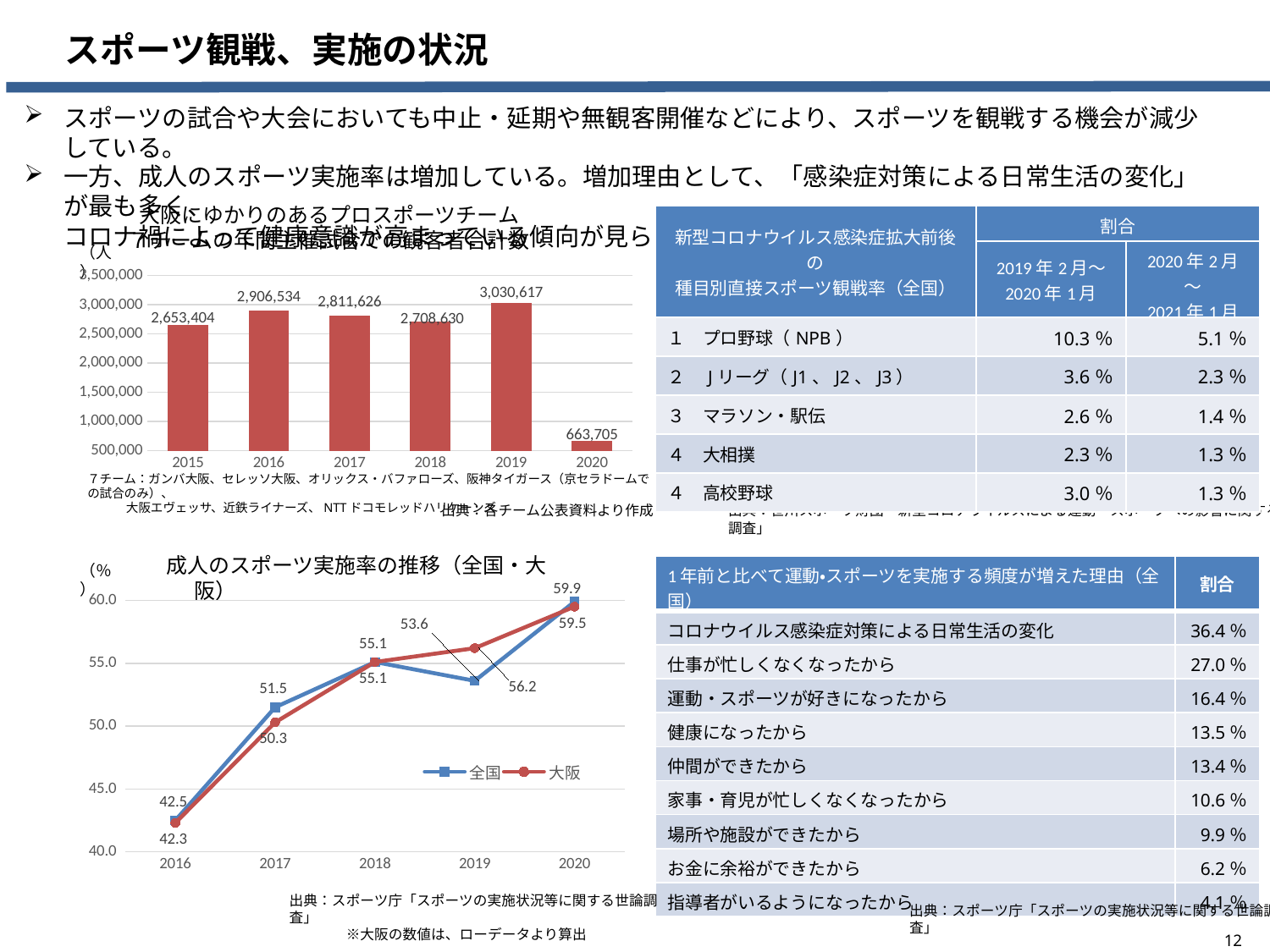
In the chart titled 成人のスポーツ実施率の推移（全国・大阪）, what is the value for 全国 in 2020? 59.9 In the top-left bar chart, which year has the lowest value? 2020 In the top-left bar chart, what is the value for 2019? 3,030,617 In the chart titled 成人のスポーツ実施率の推移（全国・大阪）, does the 大阪 series rise or fall from 2016 to 2020? Rises In the chart titled 成人のスポーツ実施率の推移（全国・大阪）, what is the difference between the 全国 and 大阪 values in 2020? 0.4 In the chart titled 成人のスポーツ実施率の推移（全国・大阪）, what is the value for 大阪 in 2019? 56.2 In the top-left bar chart, what is the difference between the 2019 value and the 2020 value? 2,366,912 How many series does the legend list in the chart titled 成人のスポーツ実施率の推移（全国・大阪）? 2 What kind of chart is the top-left chart on the slide? Bar chart In the chart titled 成人のスポーツ実施率の推移（全国・大阪）, which series has the larger value in 2019, 全国 or 大阪? 大阪 How many years (bars) are shown in the top-left bar chart? 6 In the top-left bar chart, which year has the highest value? 2019